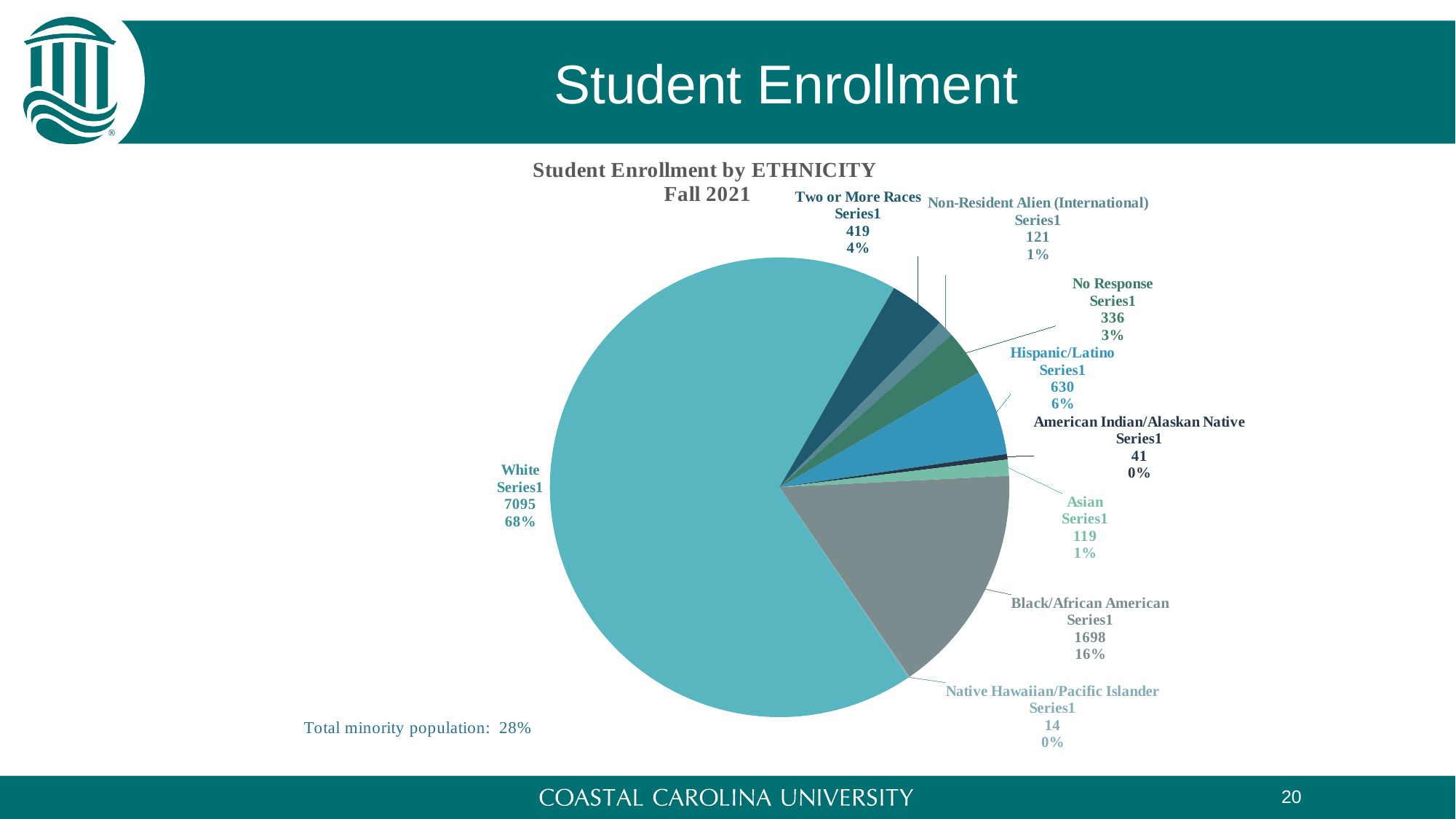
What is the value for American Indian/Alaskan Native? 41 How many categories are shown in the pie chart? 9 What share of the pie does the Black/African American slice represent? 16% What share of the pie does the White slice represent? 68% What is the difference between the Two or More Races value and the No Response value? 83 How many students are in the Hispanic/Latino category? 630 Which is larger, the Non-Resident Alien (International) value or the Asian value? Non-Resident Alien (International) Which category has the smallest slice of the pie? Native Hawaiian/Pacific Islander How many students are in the White category? 7095 Which category has the largest slice of the pie? White What is the title of the chart? Student Enrollment by ETHNICITY Fall 2021 What type of chart is shown on the slide? pie chart